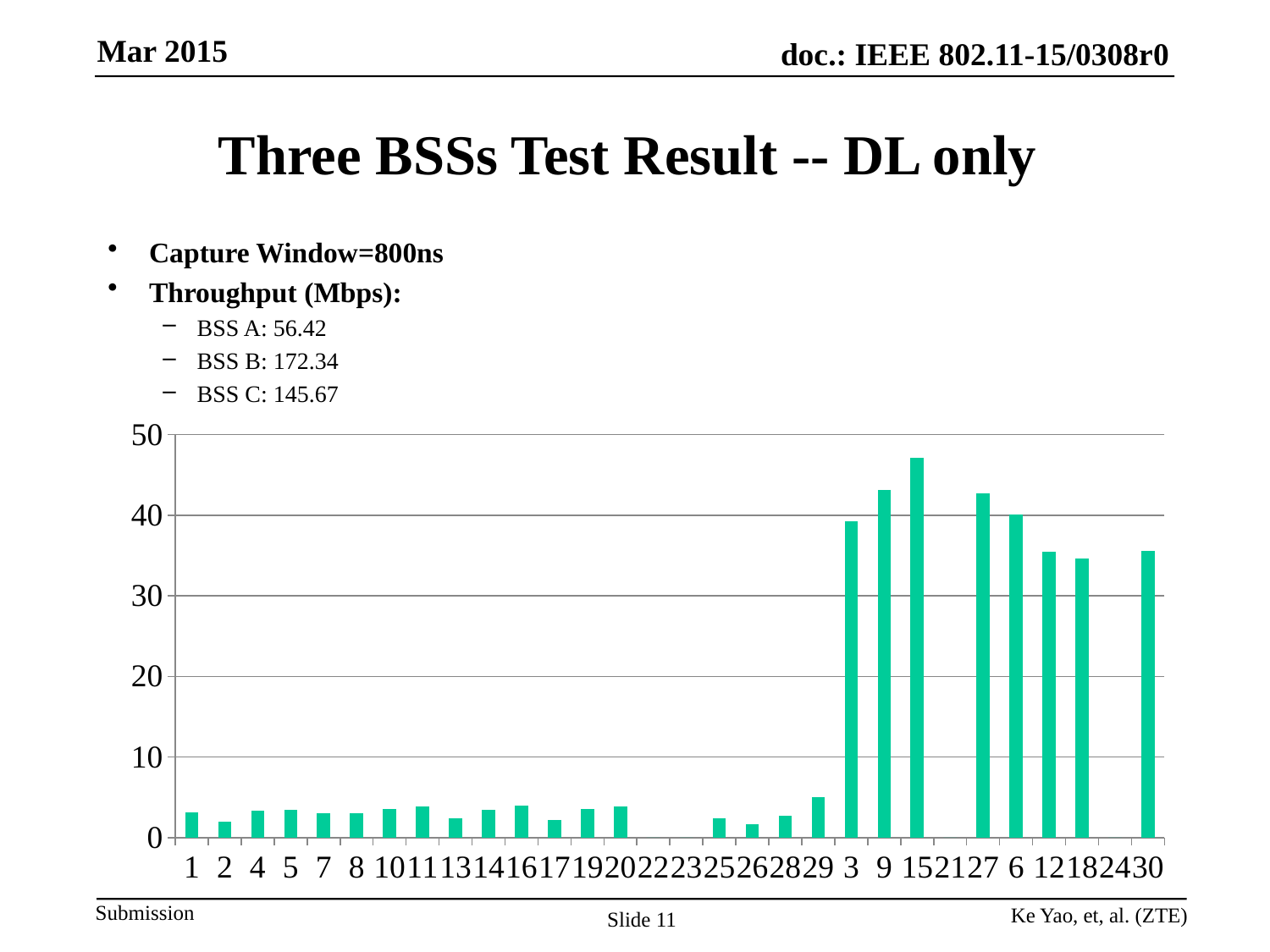
Which category has the highest bar in the chart? 15 Is the value for category 27 greater or less than 40? greater Which has the larger value, category 15 or category 9? 15 Is the value for category 15 greater or less than 40? greater Is the value for category 29 greater or less than 10? less How many categories are plotted along the x axis of the chart? 30 Which has the larger value, category 29 or category 26? 29 What is the highest value shown on the chart's y axis? 50 What kind of chart is shown on the slide? bar chart